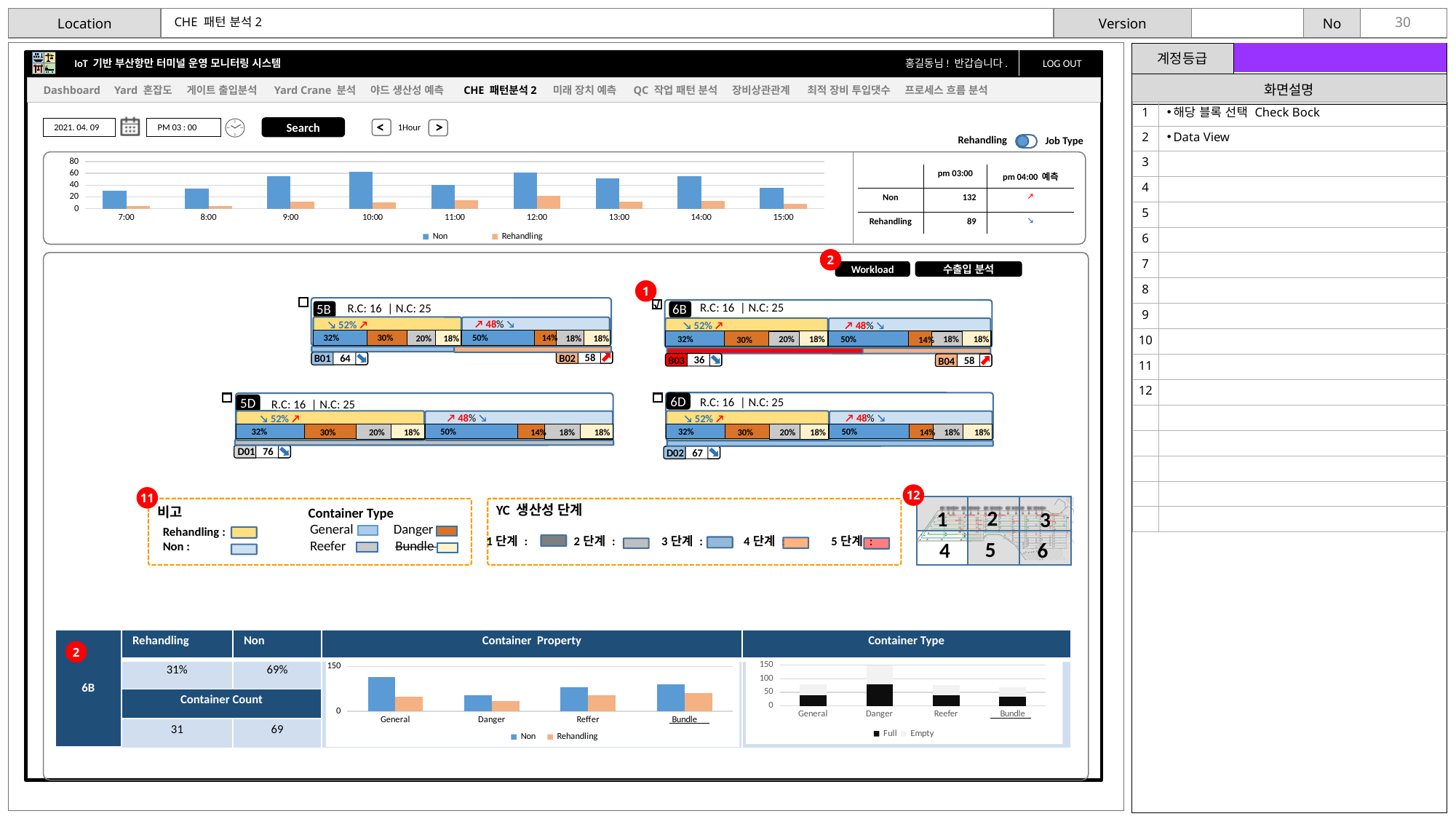
What kind of chart is the top chart showing values by hour from 7:00 to 15:00? bar chart In the top hourly chart, at which hour is the Rehandling value highest? 12:00 In the top hourly chart, is the Rehandling value at 7:00 greater or less than 20? less In the top hourly chart, which series does the orange bar represent? Rehandling In the top hourly chart, at 12:00 which is larger, Non or Rehandling? Non In the top hourly chart, is the Non value at 10:00 greater or less than 40? greater In the top hourly chart, how many series does the legend list? 2 In the Container Type chart, which two series does the legend list? Full and Empty In the Container Property chart, which category has the lowest Non value? Danger In the top hourly chart, how many time categories are shown on the x axis? 9 In the Container Property chart, which category has the highest Non value? General